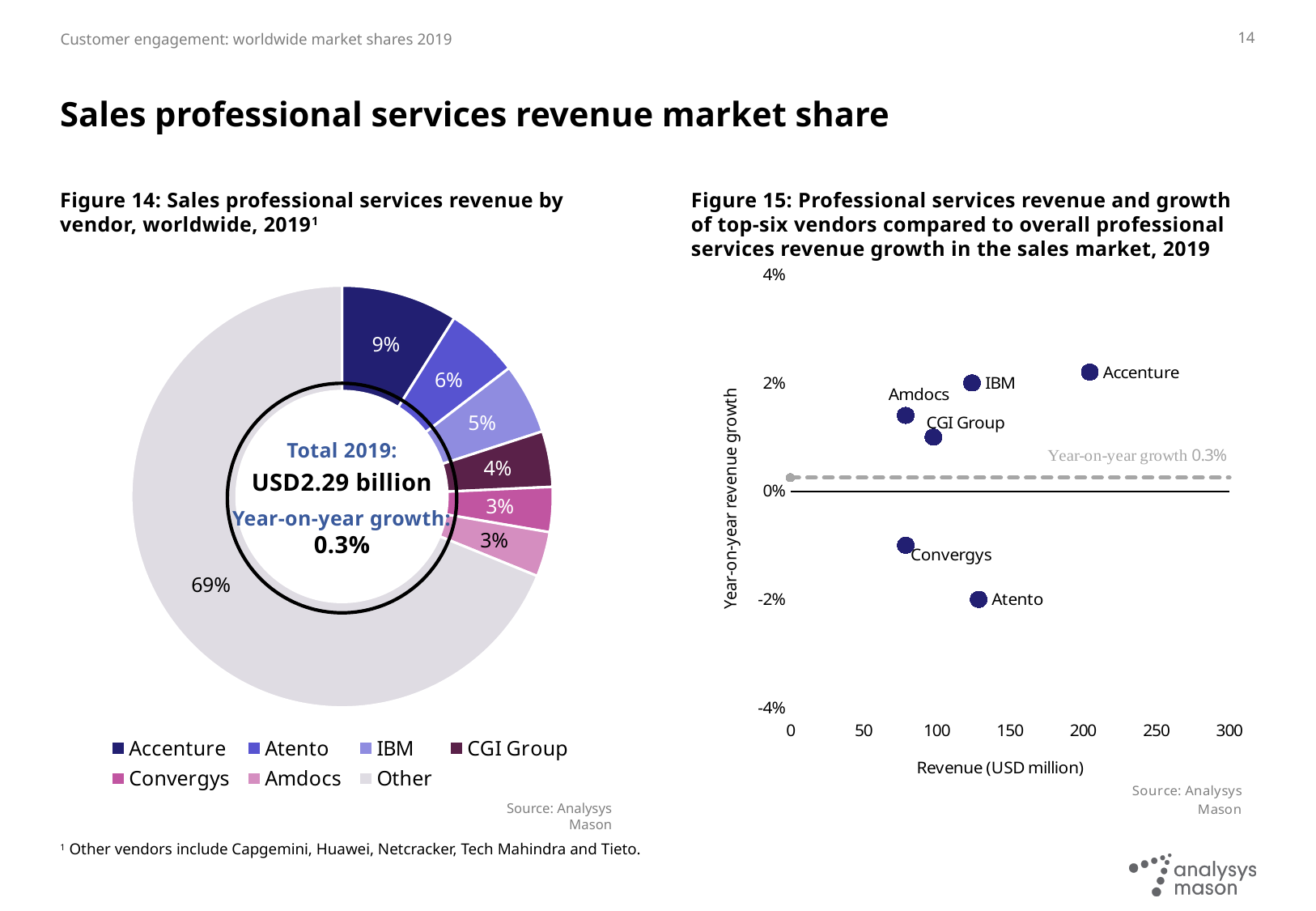
In Figure 15, which vendor has the lowest year-on-year revenue growth? Atento In Figure 14, how many entries does the legend list? 7 In Figure 15, is Accenture's revenue greater or less than 150 USD million? greater In Figure 15, how many vendors are plotted? 6 In Figure 14, which named vendor (excluding Other) has the largest share? Accenture In Figure 14, what share of sales professional services revenue does Accenture hold? 9% In Figure 14, what share is attributed to Other vendors? 69% In Figure 15, which vendor has the highest revenue? Accenture In Figure 14, what is the difference in percentage points between Accenture's share and Atento's share? 3 percentage points What kind of chart is Figure 15? Scatter chart In Figure 14, what is the total sales professional services revenue for 2019 shown in the centre of the chart? USD2.29 billion What kind of chart is Figure 14? Pie (donut) chart